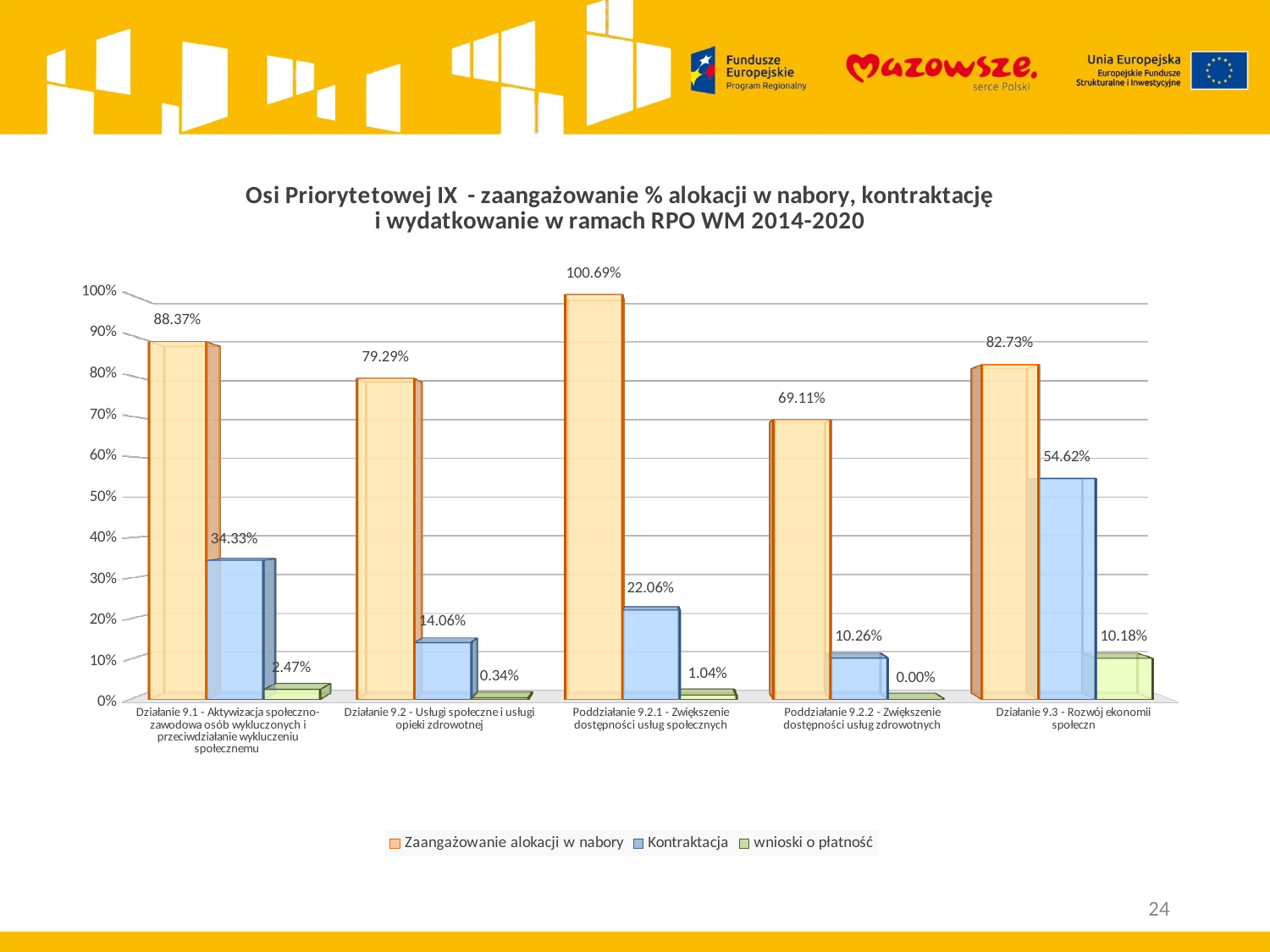
How many series does the legend list? 3 What is the Kontraktacja value for Działanie 9.3 - Rozwój ekonomii społeczn? 54.62% What is the value of Zaangażowanie alokacji w nabory for Poddziałanie 9.2.1 - Zwiększenie dostępności usług społecznych? 100.69% What is the wnioski o płatność value for Poddziałanie 9.2.2 - Zwiększenie dostępności usług zdrowotnych? 0.00% Which is larger: the Kontraktacja value for Działanie 9.1 or for Poddziałanie 9.2.1? Działanie 9.1 What is the difference between the Zaangażowanie alokacji w nabory and Kontraktacja values for Działanie 9.2 - Usługi społeczne i usługi opieki zdrowotnej? 65.23% What kind of chart is shown on the slide? Bar chart Which category has the lowest Kontraktacja value? Poddziałanie 9.2.2 - Zwiększenie dostępności usług zdrowotnych What is the wnioski o płatność value for Działanie 9.1 - Aktywizacja społeczno-zawodowa osób wykluczonych i przeciwdziałanie wykluczeniu społecznemu? 2.47% Which category has the highest Zaangażowanie alokacji w nabory value? Poddziałanie 9.2.1 - Zwiększenie dostępności usług społecznych What is the name of the third series in the legend? wnioski o płatność How many categories are shown on the x axis? 5